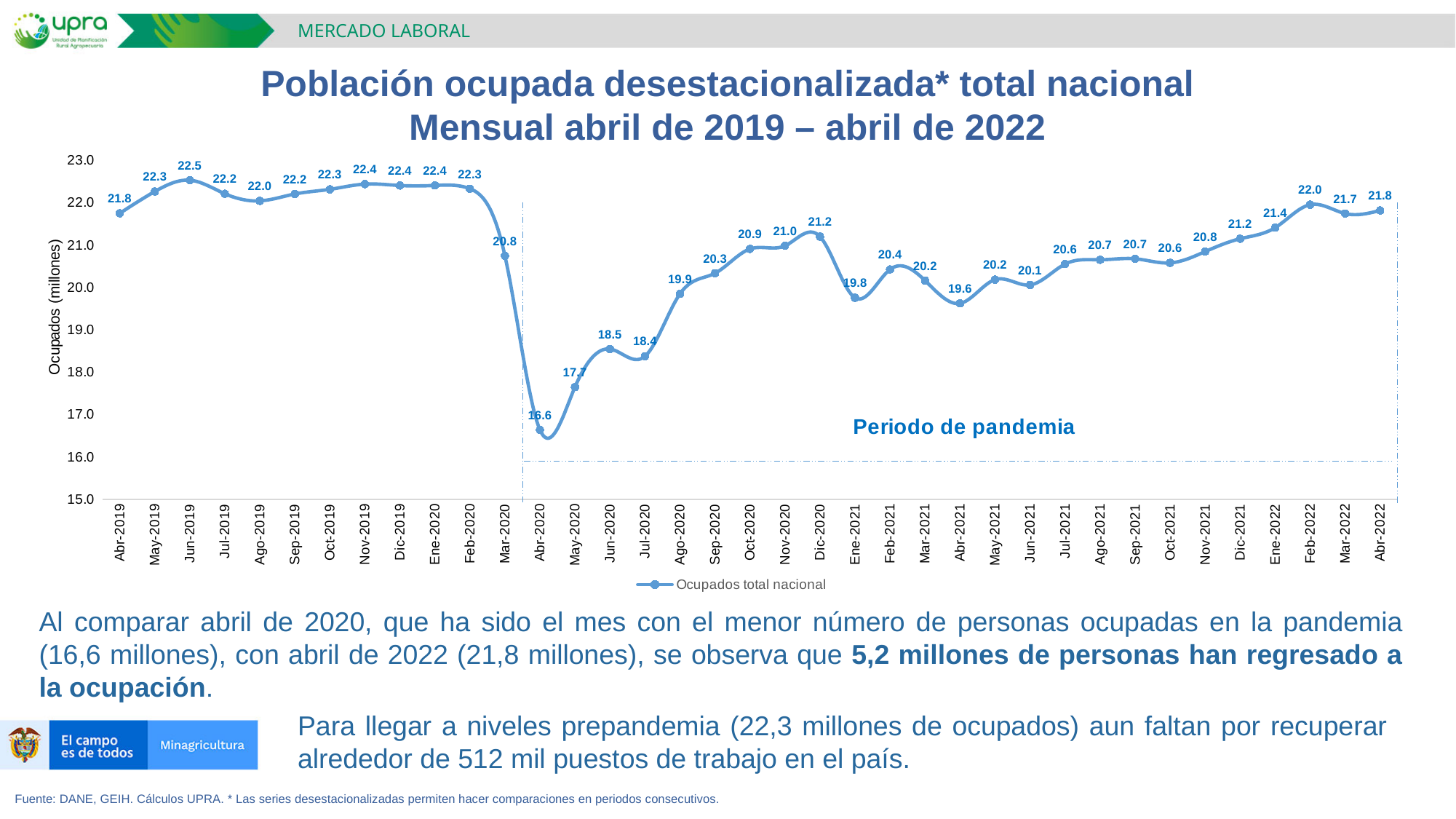
What kind of chart is this? Line chart Which month has the highest value? Jun-2019 What is the difference between the values for Abr-2022 and Abr-2020? 5.2 How many monthly data points are plotted? 37 What is the value for Abr-2022? 21.8 What is the value for Abr-2020? 16.6 Which month has the lowest value? Abr-2020 What is the difference between the values for Feb-2020 and Mar-2020? 1.5 How many series does the legend list? 1 Which is larger, the value for Feb-2022 or the value for Mar-2022? Feb-2022 What is the value for Dic-2020? 21.2 Do the values rise or fall from Abr-2021 to Feb-2022? Rise